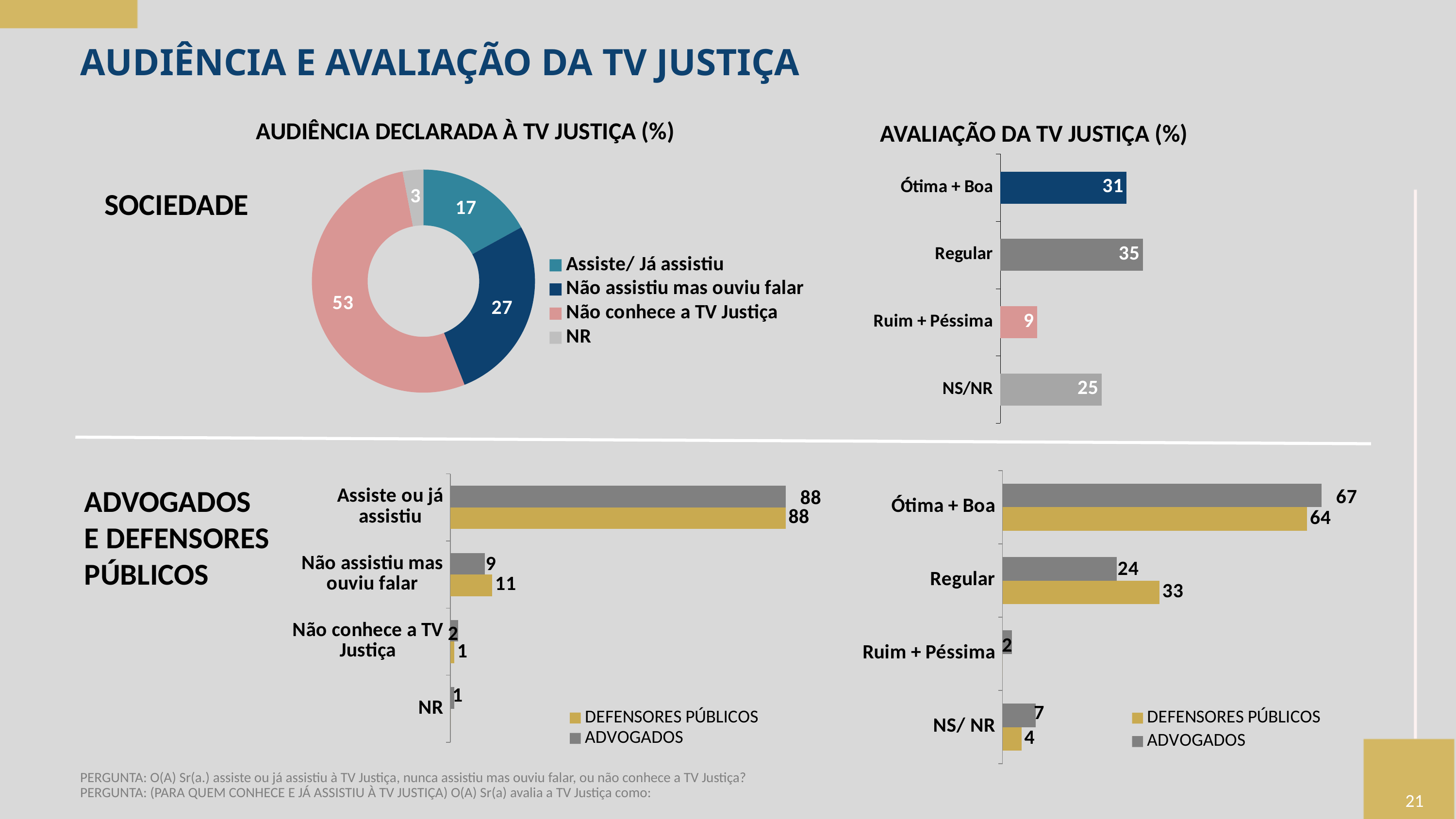
In the bottom-left bar chart for ADVOGADOS E DEFENSORES PÚBLICOS, what is the value for DEFENSORES PÚBLICOS in 'Não assistiu mas ouviu falar'? 11 In the top-left donut chart 'AUDIÊNCIA DECLARADA À TV JUSTIÇA (%)' for SOCIEDADE, what is the value for 'Não conhece a TV Justiça'? 53 In the bottom-right bar chart for ADVOGADOS E DEFENSORES PÚBLICOS, what is the value for ADVOGADOS in 'Ótima + Boa'? 67 In the top-left donut chart for SOCIEDADE, which category has the smallest share? NR In the top-left donut chart for SOCIEDADE, how many categories does the legend list? 4 In the top-right bar chart 'AVALIAÇÃO DA TV JUSTIÇA (%)' for SOCIEDADE, which category has the lowest value? Ruim + Péssima In the top-right bar chart for SOCIEDADE, what is the difference between 'Regular' and 'Ótima + Boa'? 4 In the bottom-left bar chart for ADVOGADOS E DEFENSORES PÚBLICOS, how many series does the legend list? 2 In the bottom-right bar chart for ADVOGADOS E DEFENSORES PÚBLICOS, what is the difference between ADVOGADOS and DEFENSORES PÚBLICOS for 'NS/ NR'? 3 In the top-right bar chart 'AVALIAÇÃO DA TV JUSTIÇA (%)' for SOCIEDADE, what is the value for 'Regular'? 35 In the bottom-right bar chart for ADVOGADOS E DEFENSORES PÚBLICOS, which series has the larger value for 'Regular': DEFENSORES PÚBLICOS or ADVOGADOS? DEFENSORES PÚBLICOS What kind of chart is the top-left chart 'AUDIÊNCIA DECLARADA À TV JUSTIÇA (%)'? Donut (pie) chart